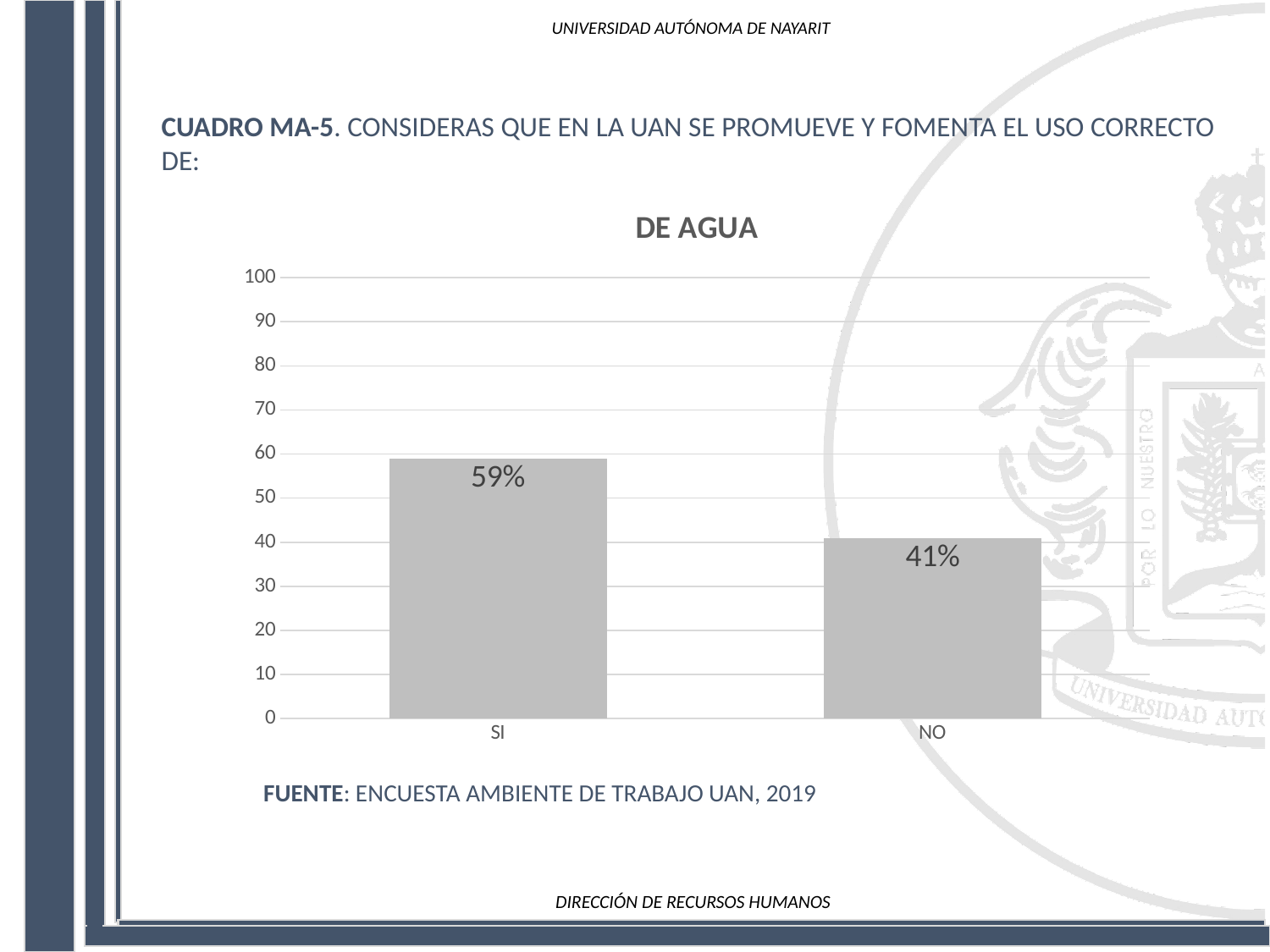
Is the value for SI greater or less than 50? greater Which is larger, the value for SI or the value for NO? SI Which category has the highest value? SI Which category has the lowest value? NO What is the difference between the values for SI and NO? 18% What is the title of the chart? DE AGUA What kind of chart is shown? bar chart What is the value for NO? 41% How many categories are shown on the x axis? 2 What is the maximum value shown on the y axis? 100 Is the value for NO greater or less than 50? less What is the value for SI? 59%